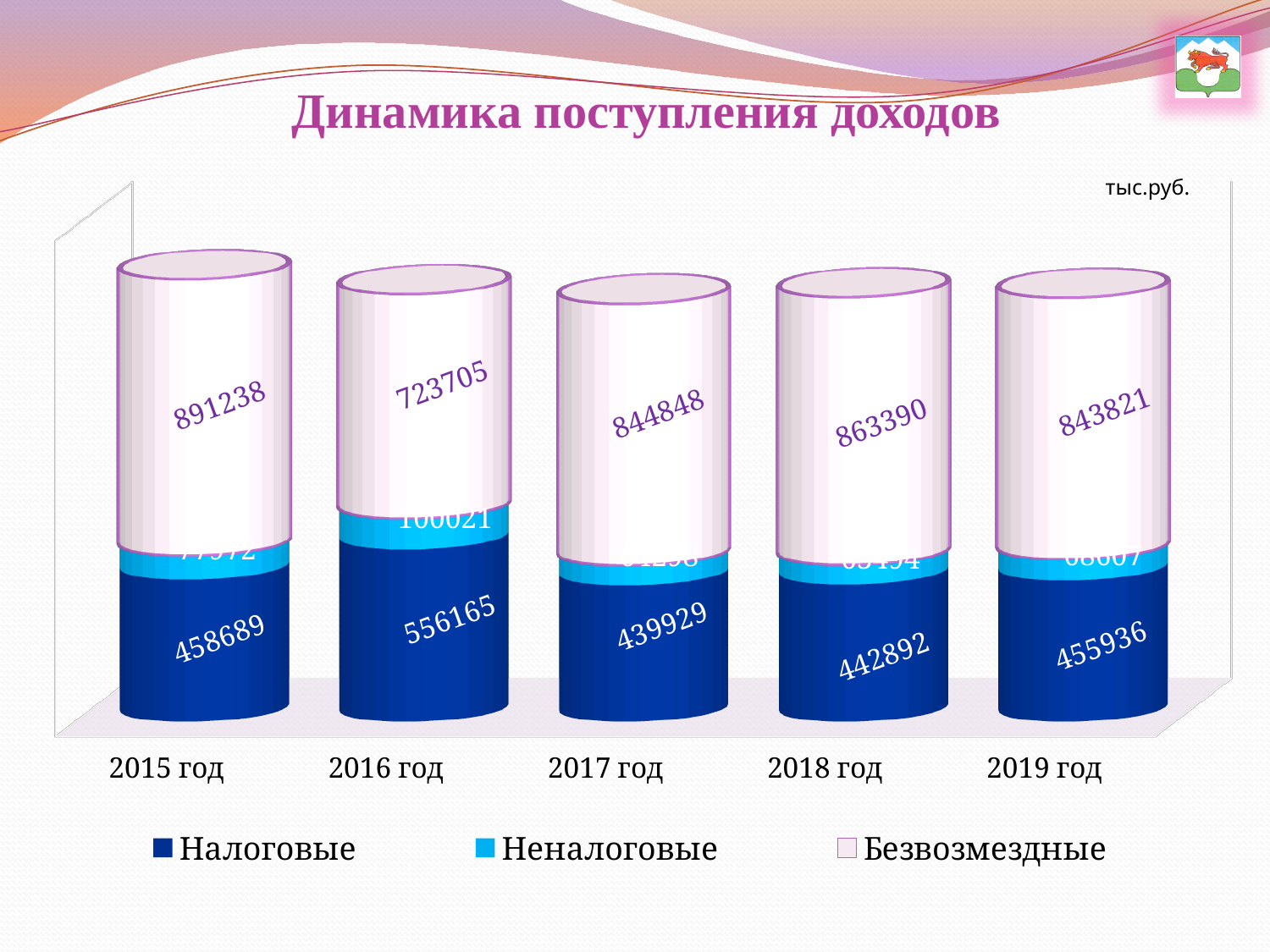
What unit of measurement is indicated on the chart? тыс.руб. What kind of chart is shown on the slide? Stacked bar chart In which year is the Налоговые value the highest? 2016 год What is the value of Безвозмездные for 2015 год? 891238 In which year is the Безвозмездные value the lowest? 2016 год By how much does the Налоговые value for 2016 год exceed that for 2015 год? 97476 How many years (categories) are shown on the x axis? 5 What is the value of Налоговые for 2016 год? 556165 In which year is the Налоговые value the lowest? 2017 год How many series does the legend list? 3 What is the value of Налоговые for 2019 год? 455936 Which year has the larger Безвозмездные value, 2017 год or 2018 год? 2018 год